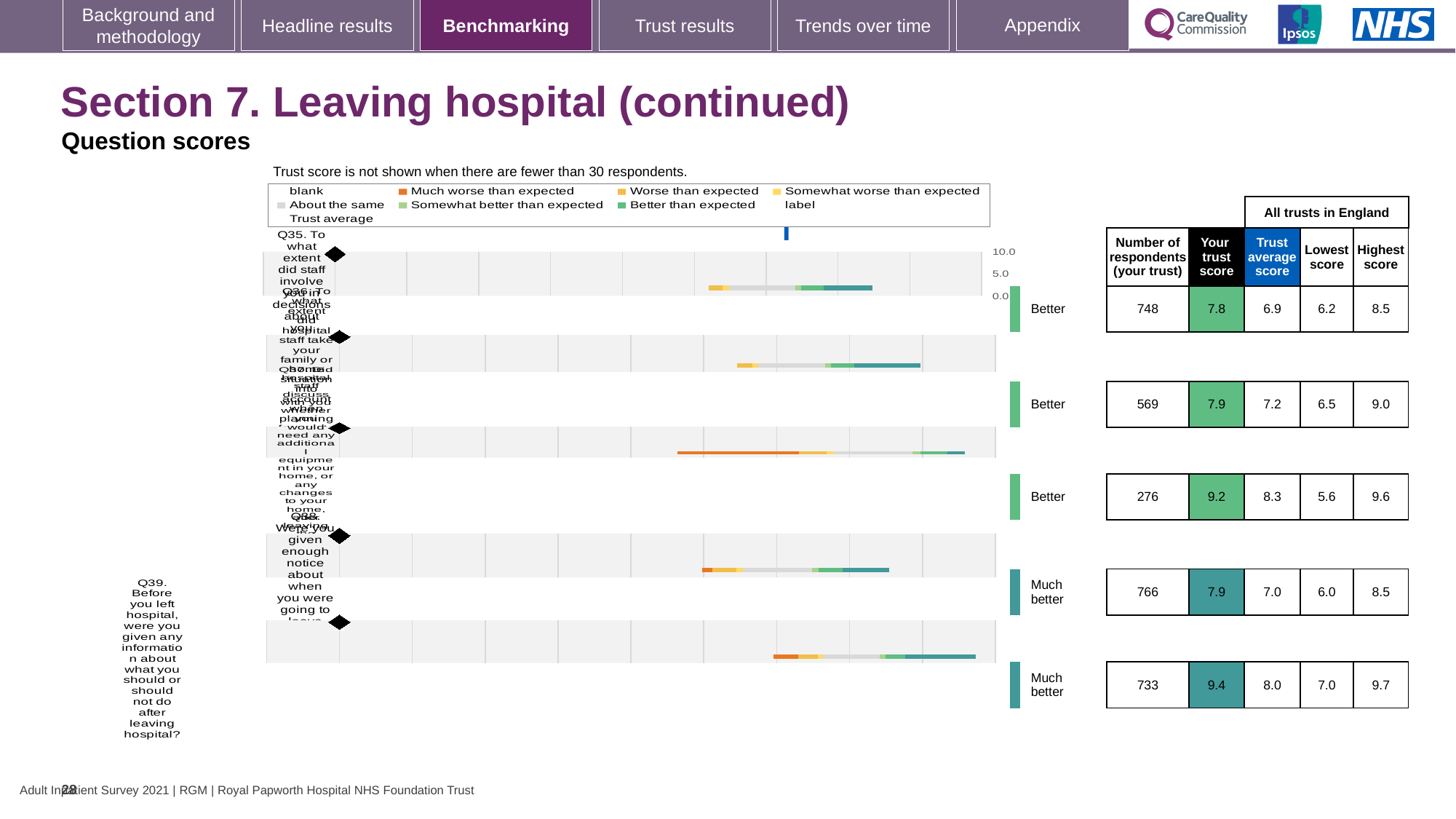
What is the highest score across all trusts in England for the last row (Q39)? 9.7 What is the trust score for Q35 (the first question row) in the table? 7.8 What is the lowest score across all trusts in England for the third question row? 5.6 What is the trust average score for the last question row (Q39)? 8.0 What is the difference between the trust score and the trust average score for the last row (Q39)? 1.4 Is the trust score for the first row (Q35) higher or lower than the trust average score for that row? Higher What is the number of respondents for Q39 (the last question row)? 733 How many question rows are shown in the benchmarking chart? 5 What is the maximum value shown on the chart's score axis? 10.0 Which question row has the fewest respondents? The third row, 276 How many rows are rated 'Much better' in the chart? 2 Which question row has the highest 'Your trust score' in the table? Q39 (the last row), 9.4